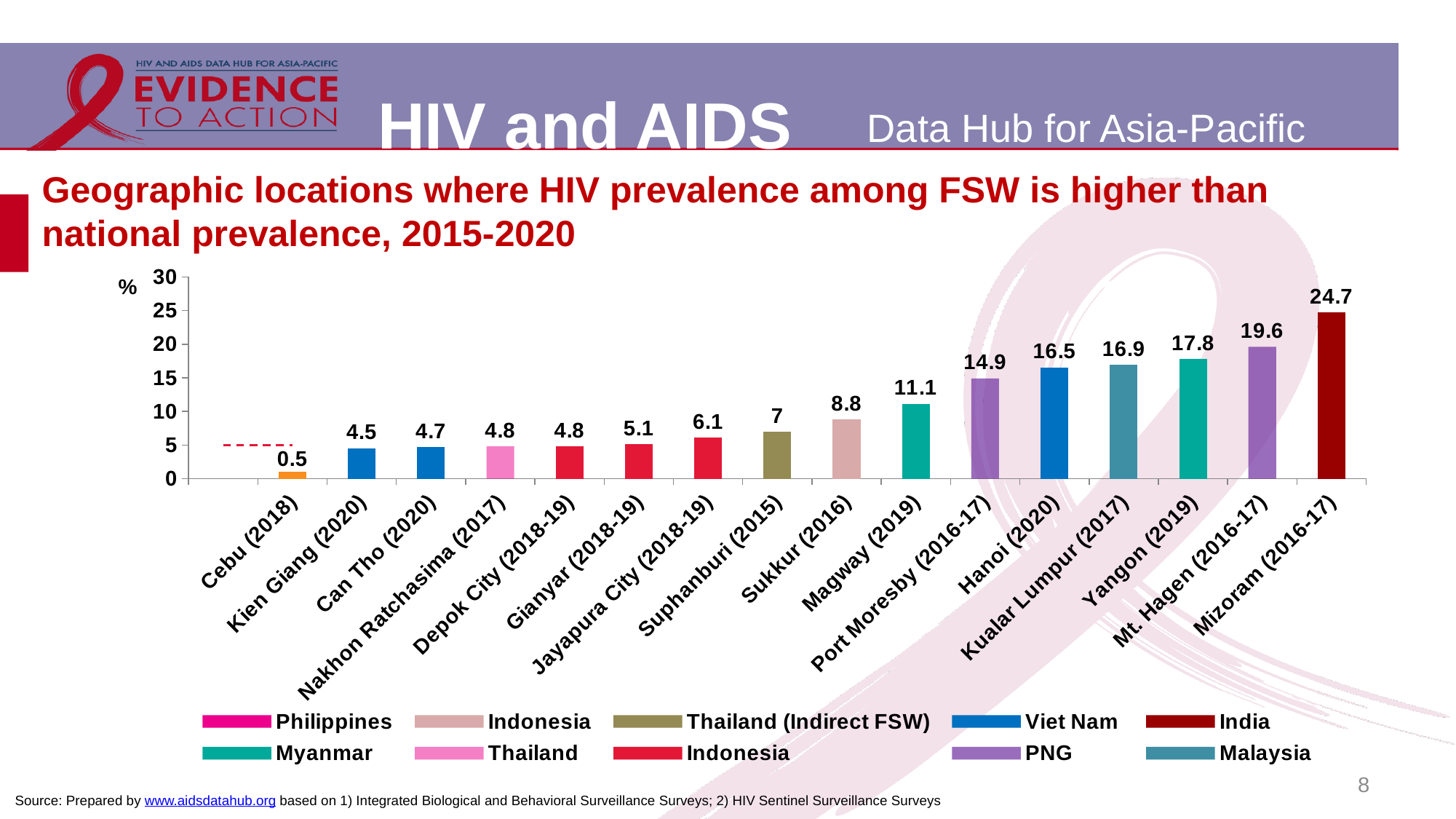
What value is shown for Port Moresby (2016-17)? 14.9 Is the value for Sukkur (2016) greater or less than 10? less What is the HIV prevalence value shown for Mizoram (2016-17)? 24.7 What is the difference between the values for Yangon (2019) and Magway (2019)? 6.7 Which location has the highest value in the chart? Mizoram (2016-17) How many entries does the legend list? 10 How many locations are plotted in the chart? 16 What value is shown for Suphanburi (2015)? 7 Which location has the lowest value in the chart? Cebu (2018) What value is shown for Hanoi (2020)? 16.5 Which has a larger value, Kualar Lumpur (2017) or Mt. Hagen (2016-17)? Mt. Hagen (2016-17) What type of chart is shown on the slide? Bar chart